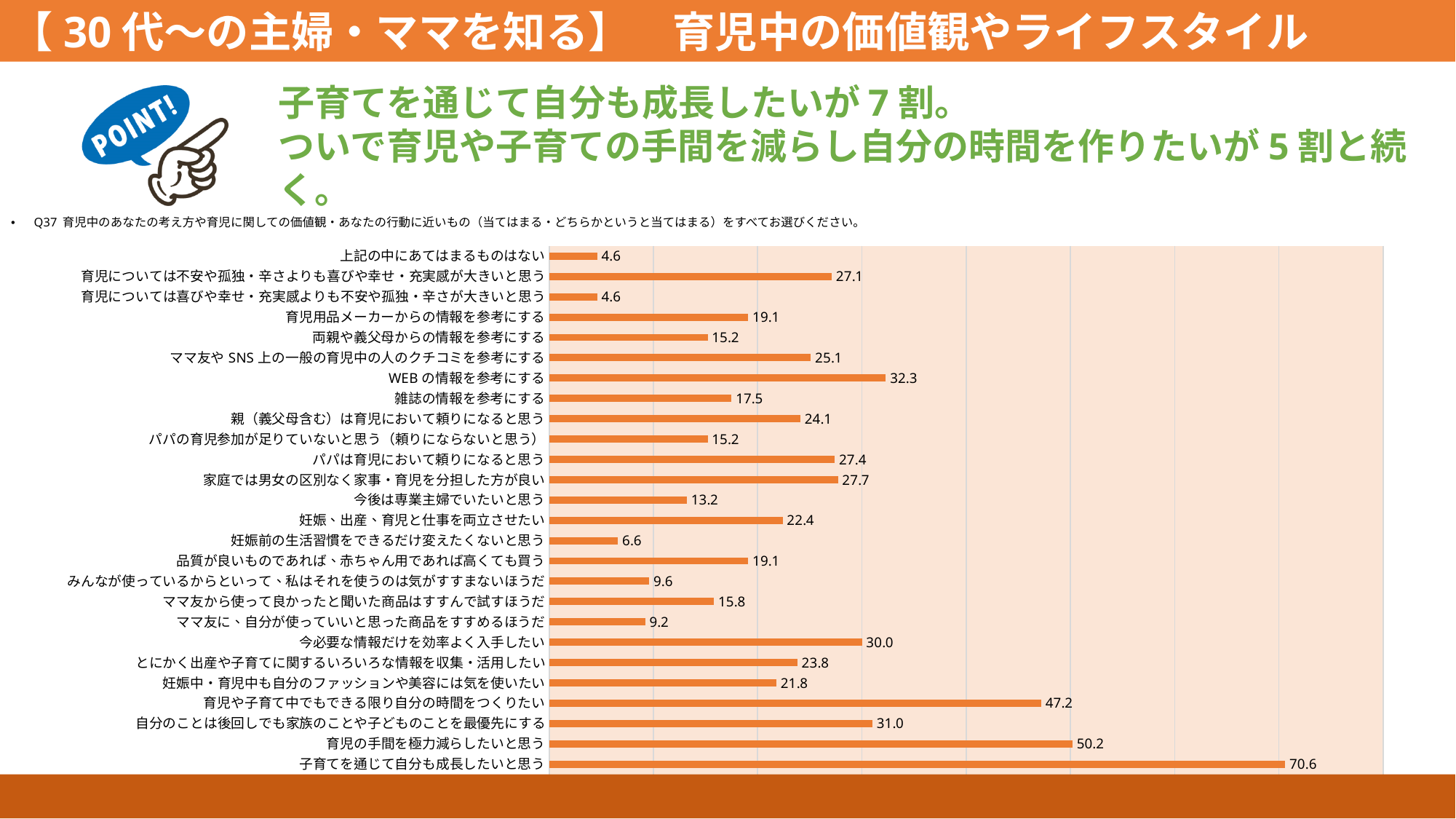
Which is larger, the value for 雑誌の情報を参考にする or the value for ママ友やSNS上の一般の育児中の人のクチコミを参考にする? ママ友やSNS上の一般の育児中の人のクチコミを参考にする What is the value for 子育てを通じて自分も成長したいと思う? 70.6 What is the value for 今必要な情報だけを効率よく入手したい? 30.0 What is the difference between the values for WEBの情報を参考にする and 雑誌の情報を参考にする? 14.8 What type of chart is shown on the slide? bar chart Which category has the highest value in the chart? 子育てを通じて自分も成長したいと思う What is the value for 育児の手間を極力減らしたいと思う? 50.2 What is the value for WEBの情報を参考にする? 32.3 Which is larger, the value for 育児や子育て中でもできる限り自分の時間をつくりたい or the value for 自分のことは後回しでも家族のことや子どものことを最優先にする? 育児や子育て中でもできる限り自分の時間をつくりたい How many categories are plotted in the chart? 26 What is the value for 今後は専業主婦でいたいと思う? 13.2 What is the difference between the values for 子育てを通じて自分も成長したいと思う and 育児の手間を極力減らしたいと思う? 20.4